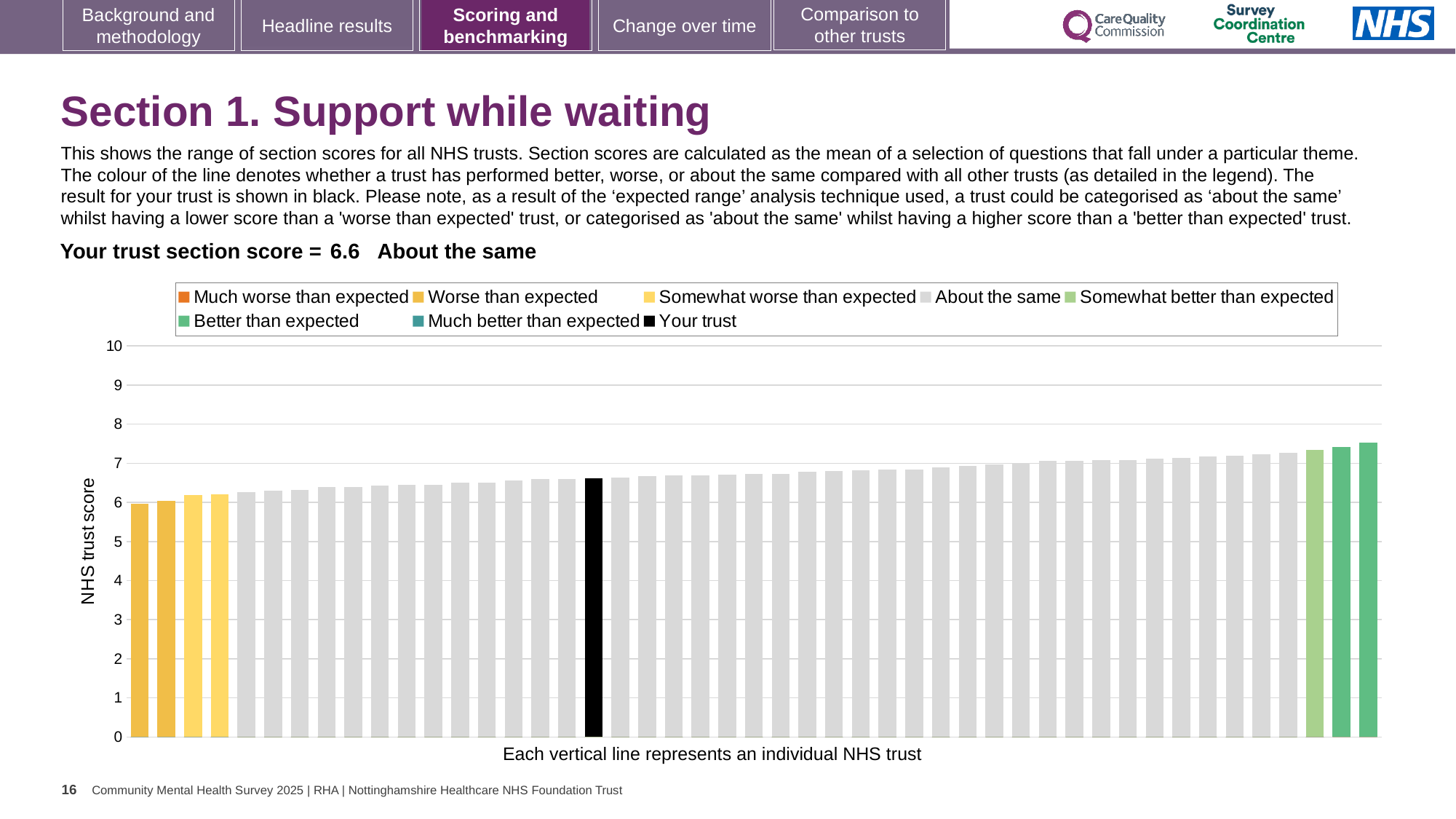
What kind of chart is shown on the slide? bar chart How many entries does the chart legend list? 8 What is the label on the vertical axis of the chart? NHS trust score Do the bar values rise or fall from left to right along the x axis? rise Is the value of the black bar (your trust) greater or less than 6? greater How many bars are coloured as 'Better than expected' (green)? 2 How is your trust's section score categorised compared with other trusts? About the same How many bars are coloured as 'Worse than expected' (dark yellow)? 2 Is the value of the shortest bar greater or less than 5? greater What is the section score for your trust shown on the slide? 6.6 Is the value of the tallest bar greater or less than 7? greater What colour is used for the bar representing your trust? black